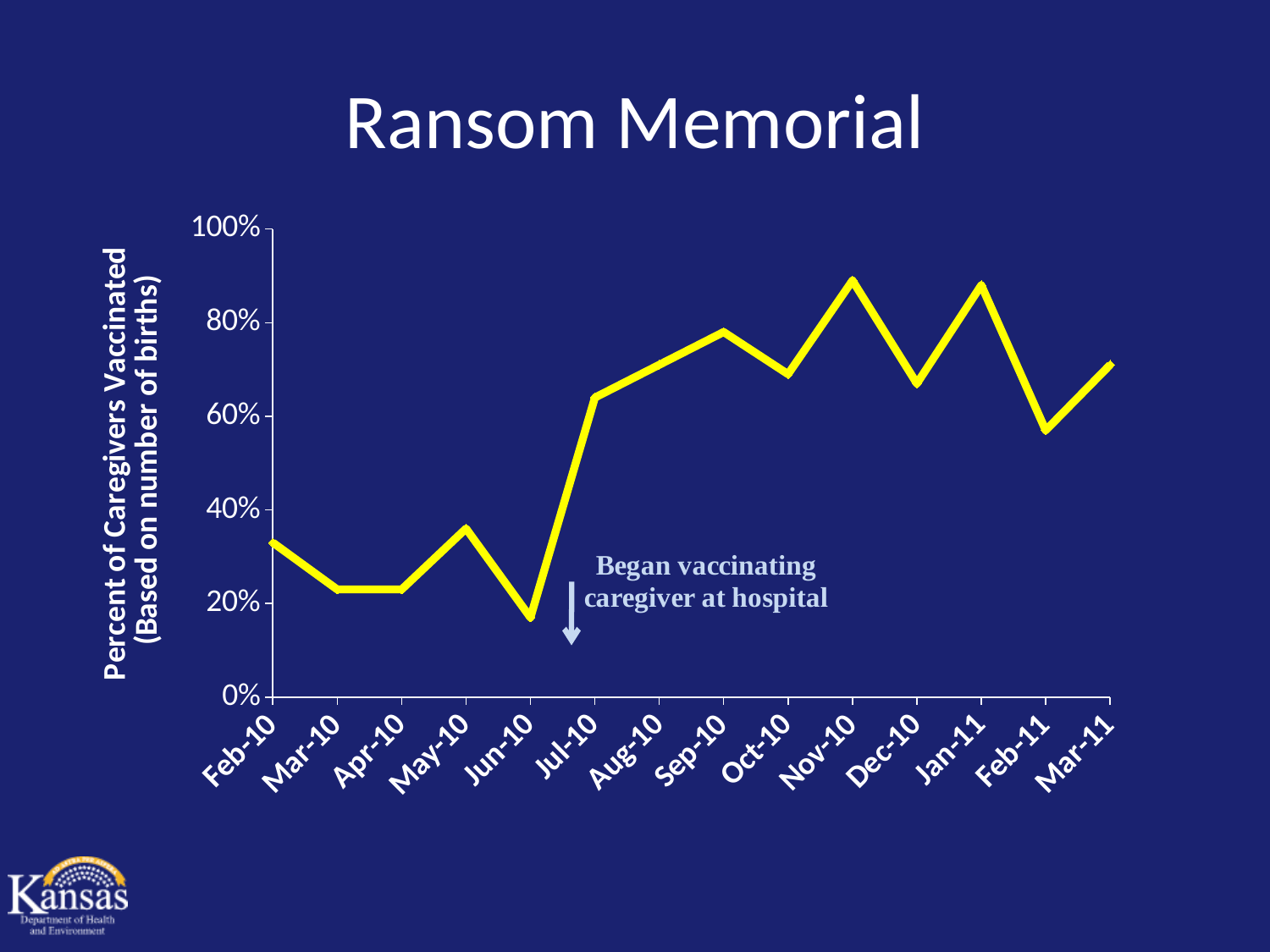
What is the title of the chart? Ransom Memorial Which is larger, the value for Jun-10 or the value for Jul-10? Jul-10 Is the value for Nov-10 greater or less than 80%? greater Which month has the lowest percent of caregivers vaccinated? Jun-10 Is the value for Mar-10 greater or less than 40%? less Does the line rise or fall from Jun-10 to Sep-10? rise What event does the annotation with the arrow near Jun-10 describe? Began vaccinating caregiver at hospital How many months are plotted along the x axis? 14 Is the value for Feb-11 greater or less than 60%? less What kind of chart is shown on the slide? line chart